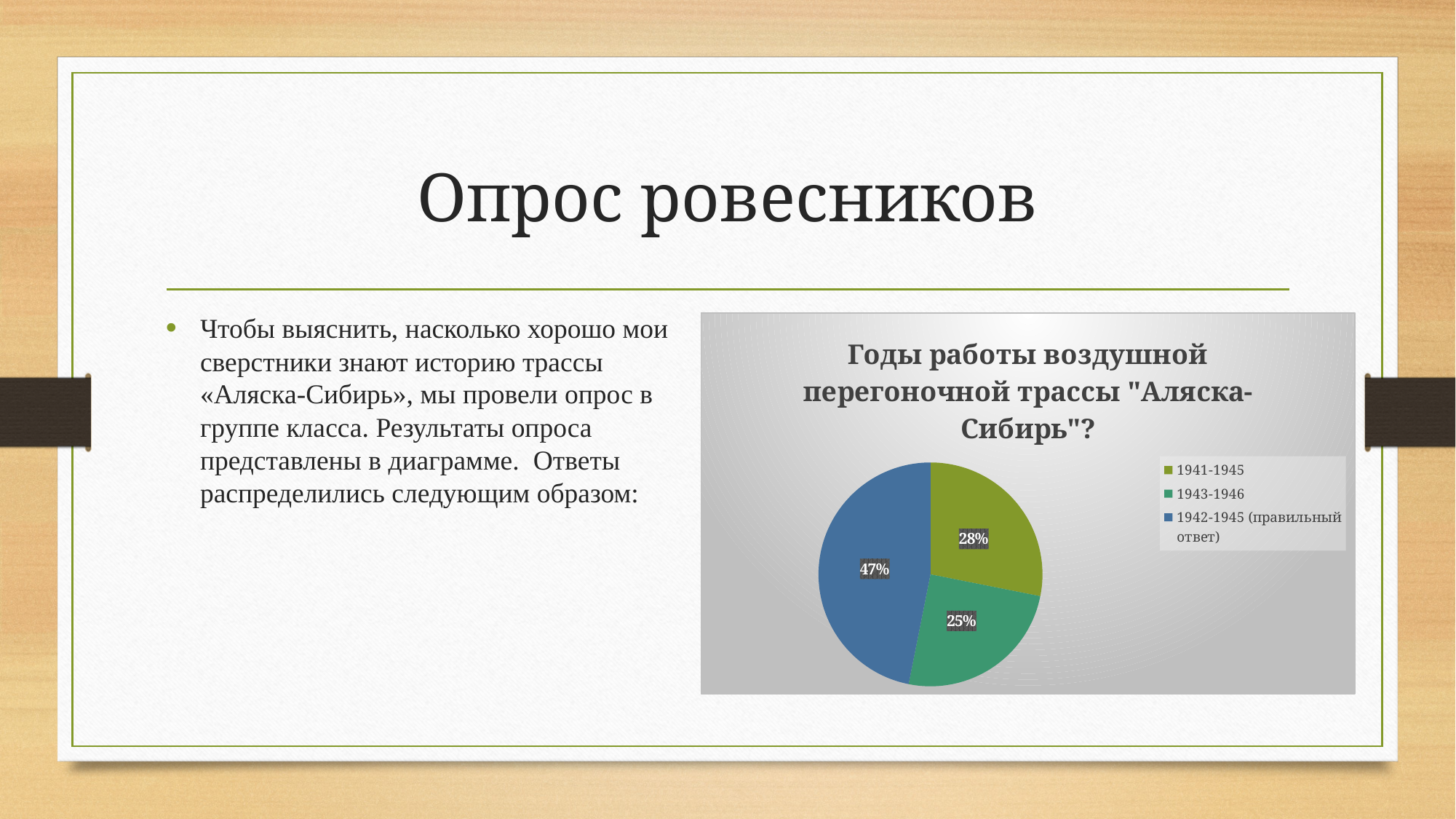
What is the difference in percentage points between the "1942-1945 (правильный ответ)" slice and the "1941-1945" slice? 19 Which slice is larger: "1941-1945" or "1943-1946"? 1941-1945 Which answer option received the largest share of responses? 1942-1945 (правильный ответ) What share of respondents answered "1943-1946"? 25% What is the title of the pie chart? Годы работы воздушной перегоночной трассы "Аляска-Сибирь"? What share of respondents chose "1942-1945 (правильный ответ)"? 47% What is the combined share of the two incorrect answers, "1941-1945" and "1943-1946"? 53% Which answer option received the smallest share of responses? 1943-1946 What share of respondents answered "1941-1945"? 28% How many answer options (slices) does the pie chart show? 3 What colour is the slice for "1942-1945 (правильный ответ)"? blue What type of chart is shown on the slide? pie chart